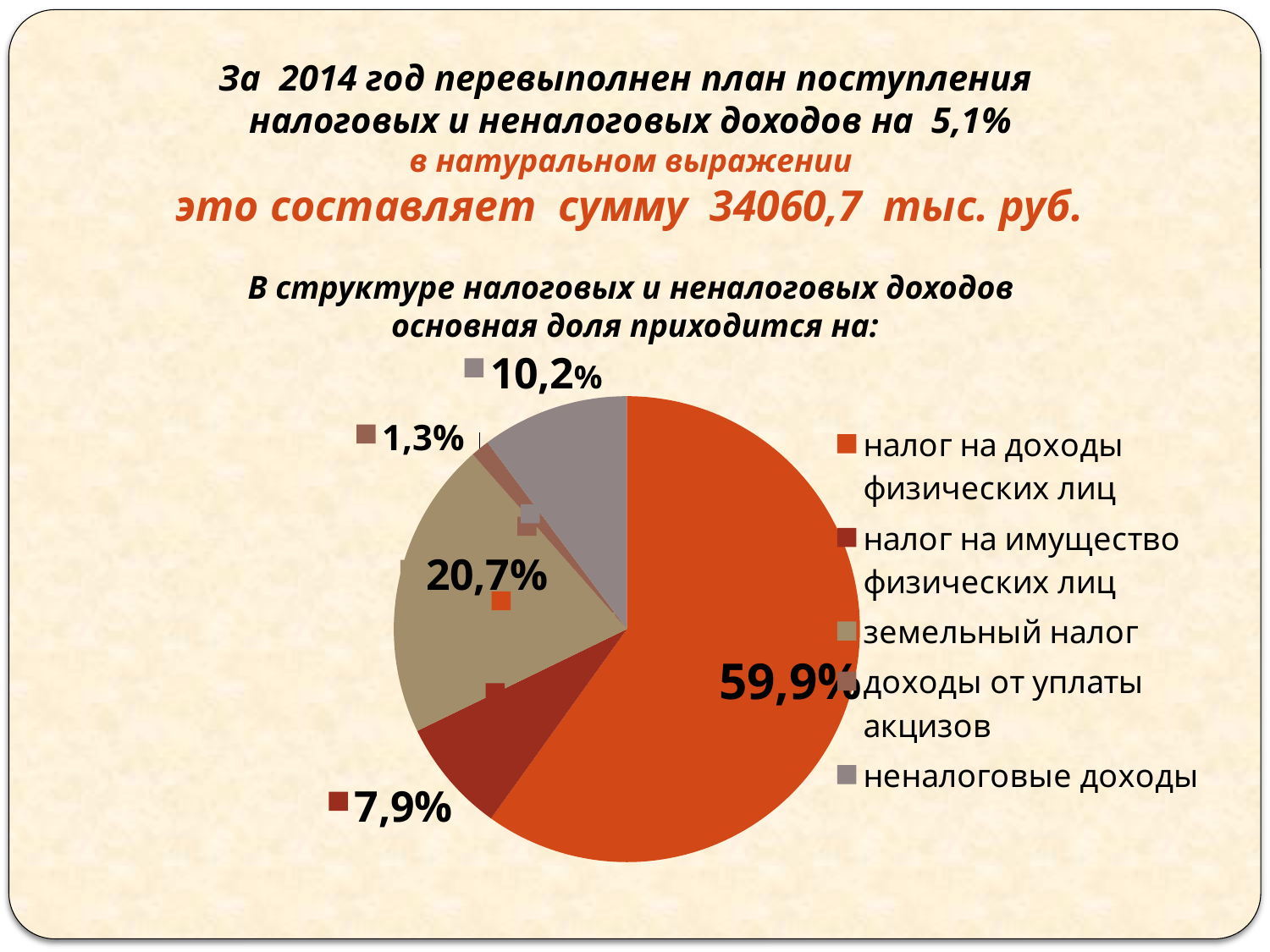
What share of the pie does "неналоговые доходы" have? 10,2% What share of the pie does "земельный налог" have? 20,7% What share of the pie does "налог на имущество физических лиц" have? 7,9% Which category has the largest slice of the pie? налог на доходы физических лиц What kind of chart is shown on the slide? pie chart Which category has the smallest slice of the pie? доходы от уплаты акцизов How many entries does the legend list? 5 What is the difference in percentage points between the share for "налог на доходы физических лиц" and the share for "земельный налог"? 39,2 What share of the pie does "доходы от уплаты акцизов" have? 1,3% How many slices does the pie chart have? 5 Which is larger: the share for "земельный налог" or the share for "неналоговые доходы"? земельный налог What share of the pie does "налог на доходы физических лиц" have? 59,9%